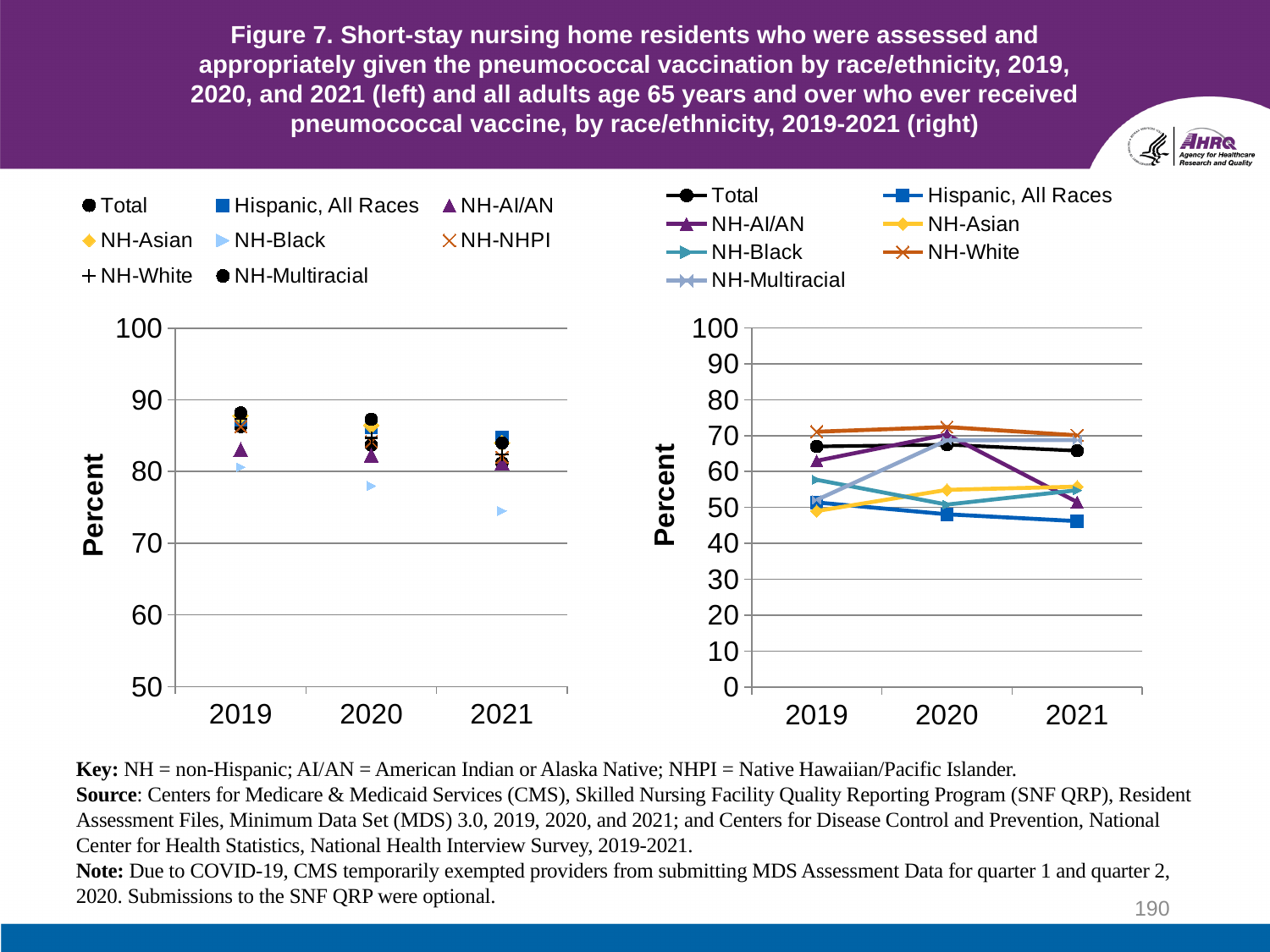
In the right chart, which race/ethnicity group has the highest value in 2020? NH-White In the right chart, is the value for Total in 2021 greater or less than 60? greater What kind of chart is the right chart (all adults age 65 and over)? Line chart How many series does the legend of the left chart (short-stay nursing home residents) list? 8 In the right chart, which is larger in 2021: NH-White or NH-AI/AN? NH-White In the right chart, which race/ethnicity group has the lowest value in 2021? Hispanic, All Races How many series does the legend of the right chart (all adults age 65 and over) list? 7 In the left chart, does the value for NH-Black rise or fall from 2019 to 2021? Fall In the left chart, which race/ethnicity group has the lowest value in 2021? NH-Black How many years are shown on the x axis of the left chart? 3 In the left chart, is the value for NH-Black in 2021 greater or less than 80? less In the right chart, is the value for Hispanic, All Races in 2021 greater or less than 50? less